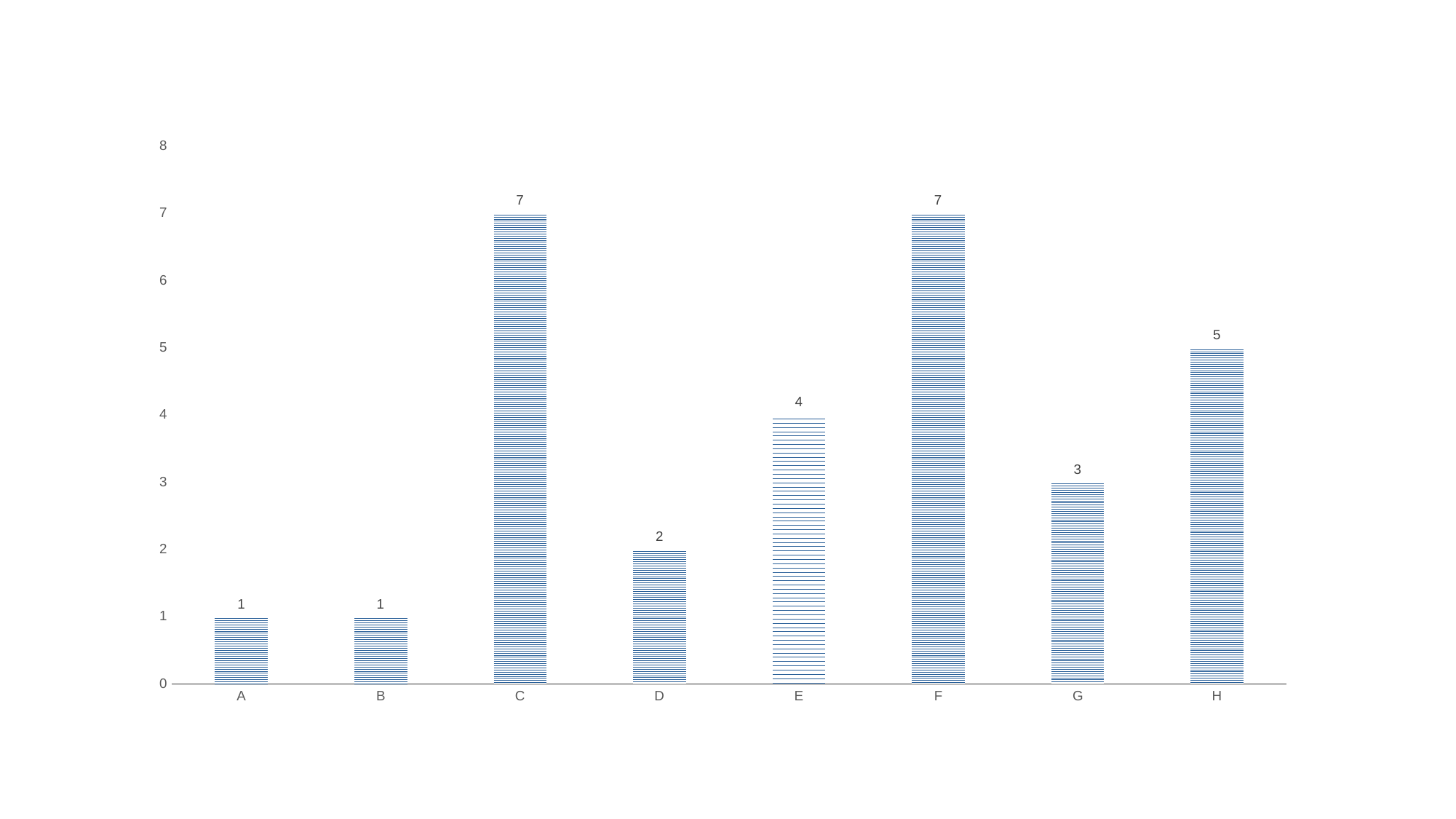
Which is larger, the value for D or the value for H? H What is the value for category E? 4 What is the difference between the values for C and D? 5 How many categories are shown on the x axis? 8 What kind of chart is shown on the slide? bar chart What is the value for category C? 7 What is the difference between the values for H and G? 2 What is the value for category G? 3 Is the value for F greater or less than 6? greater What is the value for category H? 5 Which is larger, the value for E or the value for G? E What is the value for category D? 2